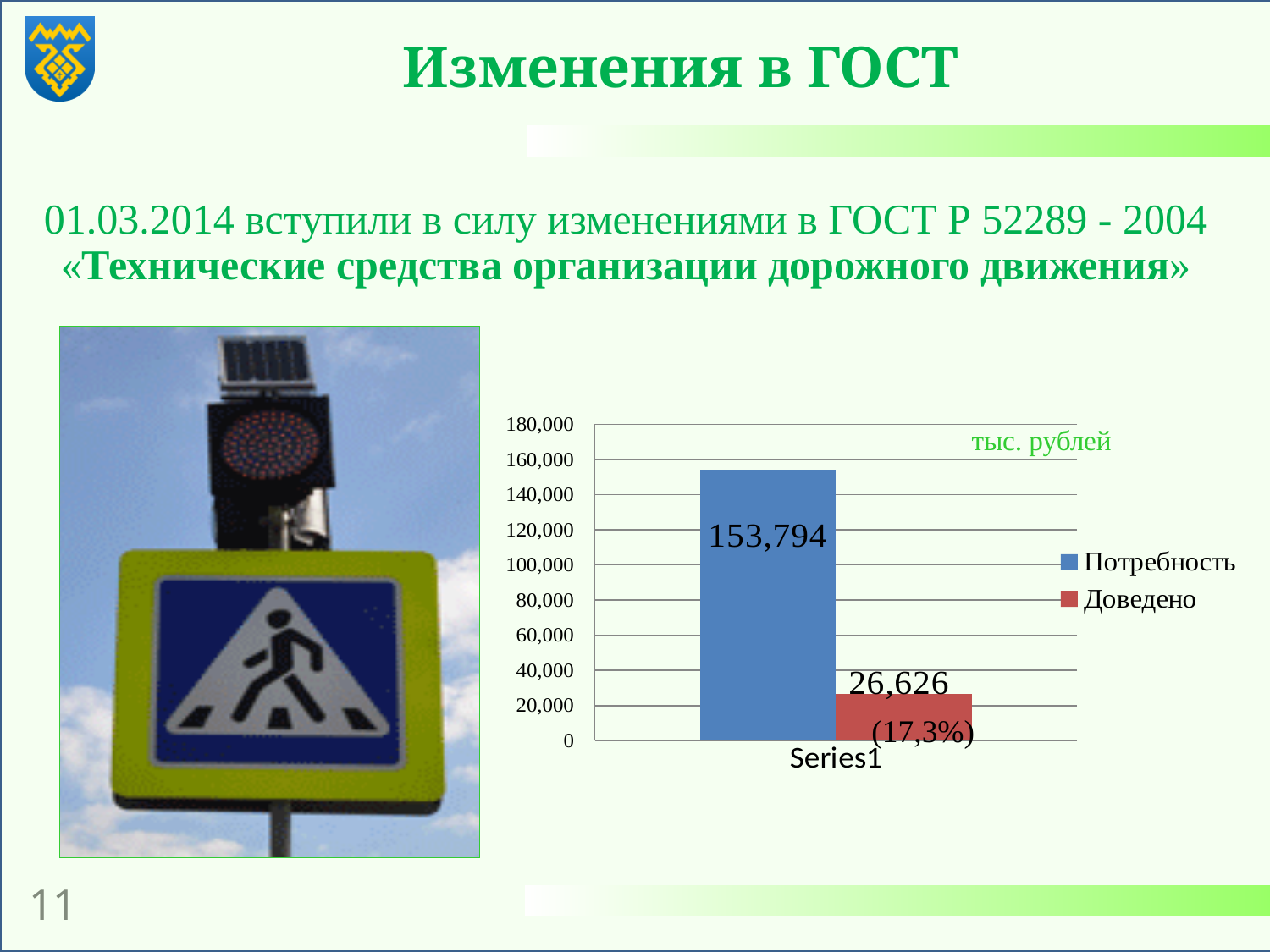
What is the value for Доведено? 26,626 Which series has the lowest value? Доведено Is the value for Доведено greater or less than 40,000? less What is the value for Потребность? 153,794 How many series does the legend list? 2 Which series has the higher value, Потребность or Доведено? Потребность What kind of chart is shown on the slide? bar chart What is the difference between the Потребность and Доведено values? 127,168 What unit is indicated on the chart? тыс. рублей What colour is the Потребность bar? blue What percentage is shown next to the Доведено bar? 17,3% Is the value for Потребность greater or less than 140,000? greater